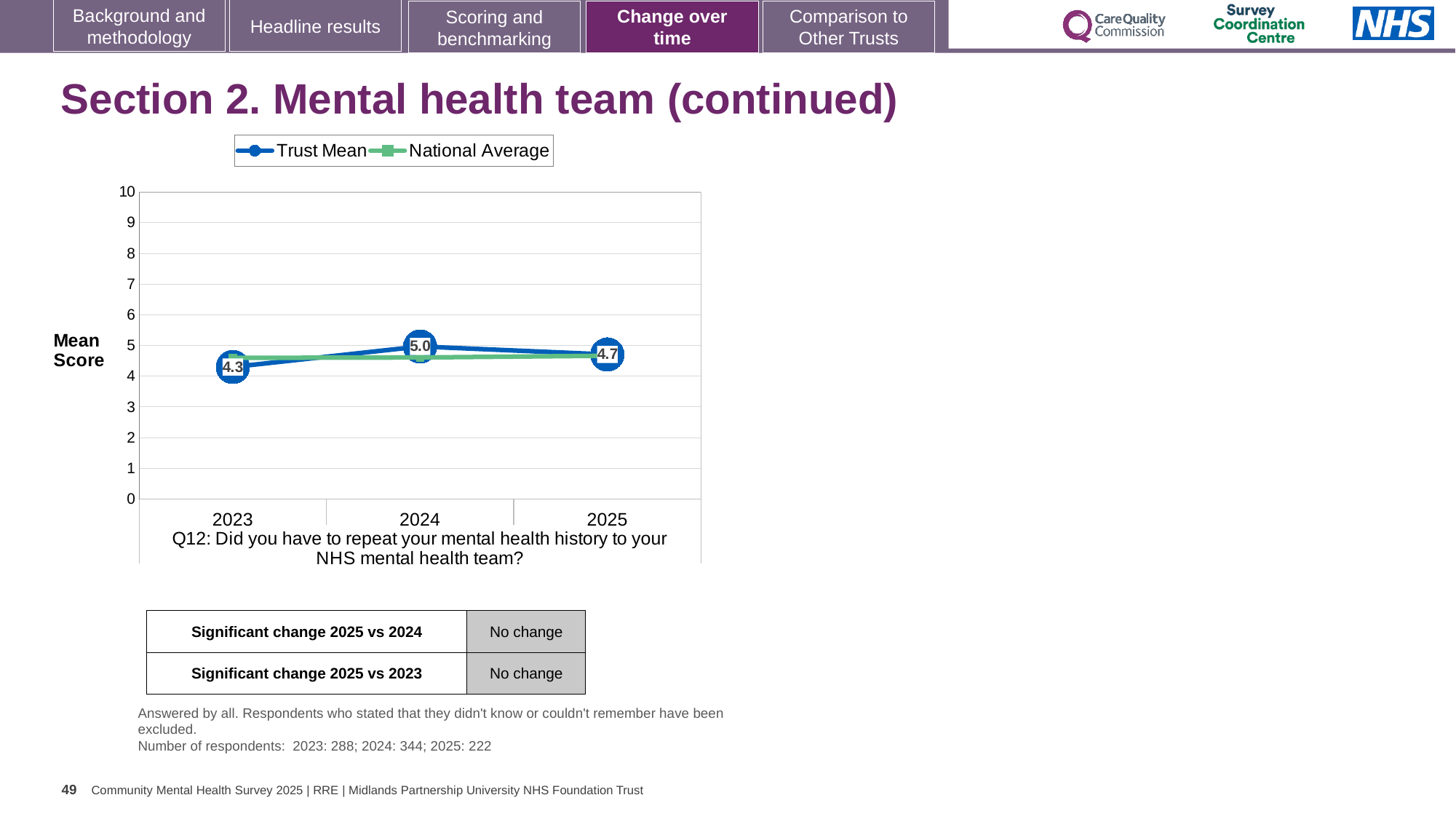
What is the difference between the Trust Mean in 2024 and in 2023? 0.7 What is the Trust Mean value for 2023? 4.3 How many series does the legend list? 2 How many years are plotted on the x axis? 3 What kind of chart is shown on the slide? Line chart What is the Trust Mean value for 2025? 4.7 What is the label on the y axis of the chart? Mean Score What is the Trust Mean value for 2024? 5.0 In which year is the Trust Mean lowest? 2023 Is the National Average value for 2023 greater or less than 5? less Which year has the larger Trust Mean, 2023 or 2025? 2025 In which year is the Trust Mean highest? 2024